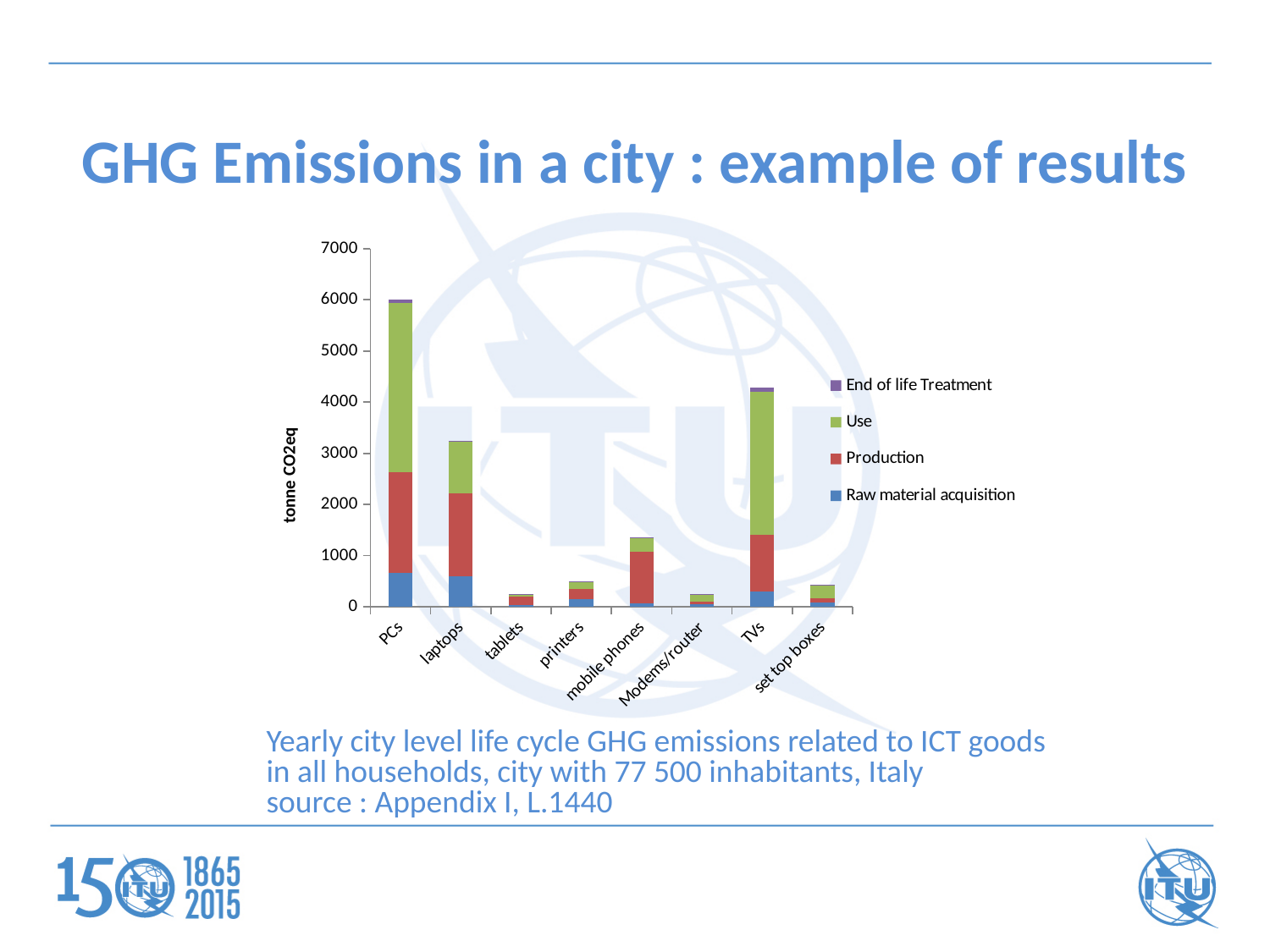
Which category has the highest total emissions in the chart? PCs What kind of chart is shown on the slide? stacked bar chart Is the total value for mobile phones greater or less than 2000? less What is the label on the vertical axis of the chart? tonne CO2eq How many product categories are shown on the x axis of the chart? 8 Is the total value for PCs greater or less than 5000? greater Which has a larger total, PCs or TVs? PCs Which has a larger total, laptops or mobile phones? laptops Is the total value for laptops greater or less than 3000? greater How many series does the chart's legend list? 4 Which legend entry is shown in green? Use